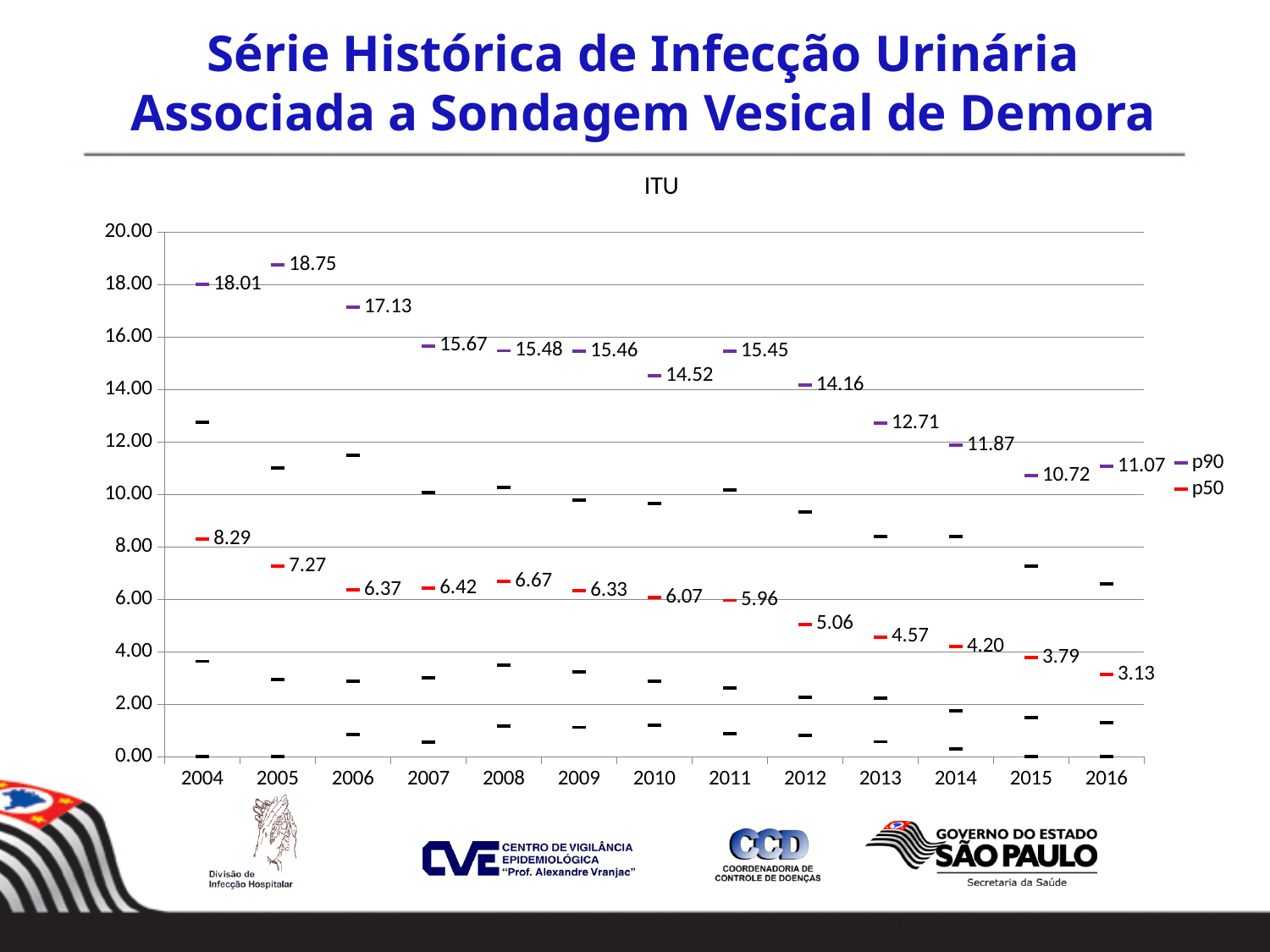
What is the p50 value for 2012? 5.06 What is the p90 value for 2016? 11.07 Does the p50 value generally rise or fall from 2004 to 2016? fall How many series does the legend list? 2 In which year is the p50 value lowest? 2016 What is the difference between the p50 values for 2004 and 2016? 5.16 Which is larger, the p90 value for 2015 or the p90 value for 2016? 2016 What is the title of the chart? ITU What is the difference between the p90 values for 2005 and 2006? 1.62 What is the p90 value for 2005? 18.75 How many years are shown on the x axis? 13 In which year is the p90 value highest? 2005